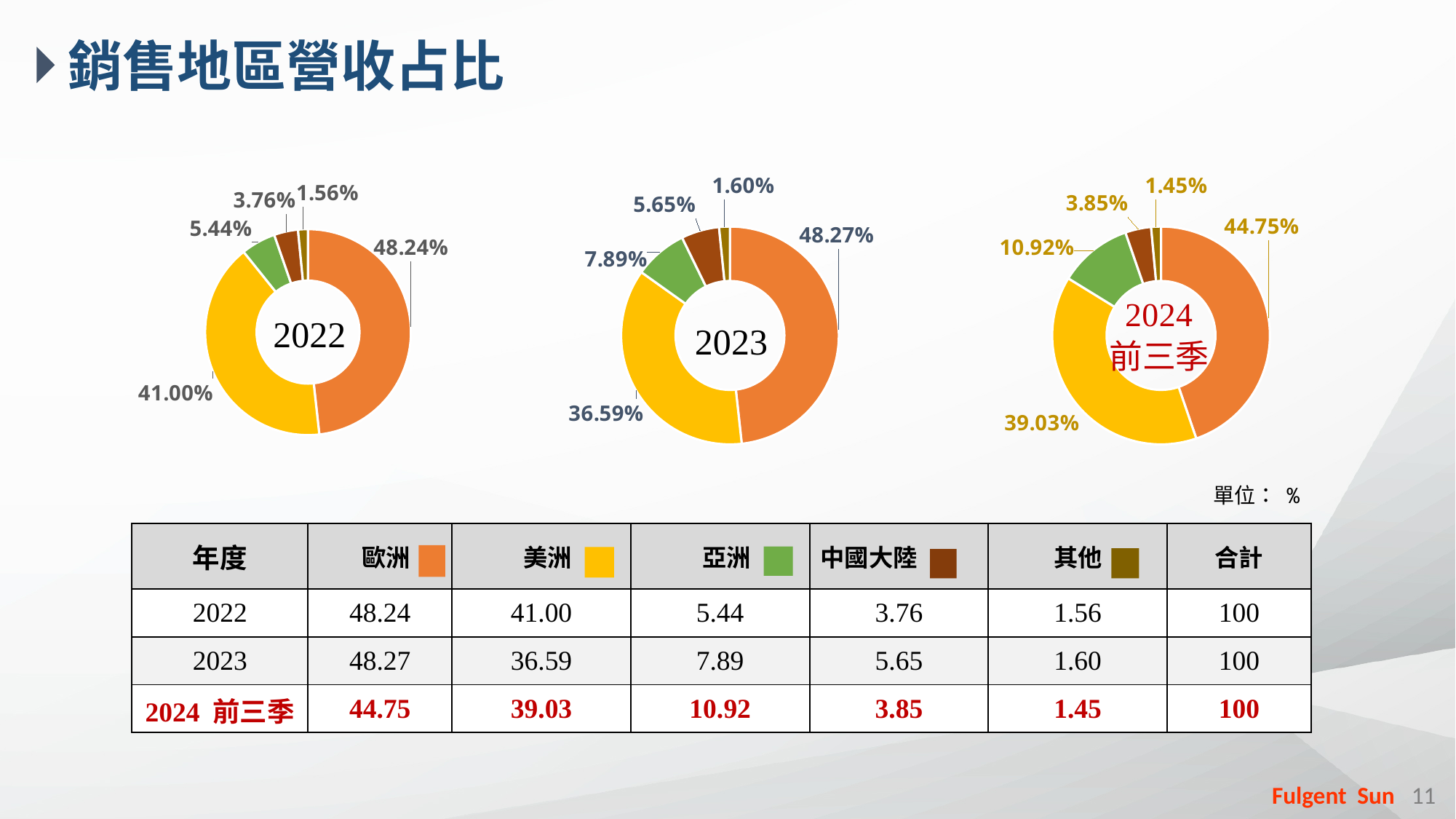
In the 2024 前三季 donut chart, what is the value for 亞洲 (the green slice)? 10.92% Which colour represents 美洲 in the donut charts? Yellow What is the title of the slide containing the donut charts? 銷售地區營收占比 In the 2022 donut chart, what share does 歐洲 (the orange slice) hold? 48.24% How many slices does each donut chart on the slide have? 5 In the 2024 前三季 donut chart, which region has the largest share? 歐洲 In the 2024 前三季 donut chart, which is larger, the 亞洲 share or the 中國大陸 share? 亞洲 How many donut charts are shown on the slide? 3 What type of chart is used to show the regional revenue shares on this slide? Donut (pie) chart In the 2023 donut chart, what is the difference between the 歐洲 share and the 美洲 share? 11.68% In the 2023 donut chart, what is the value for 美洲 (the yellow slice)? 36.59% In the 2022 donut chart, which region has the smallest share? 其他